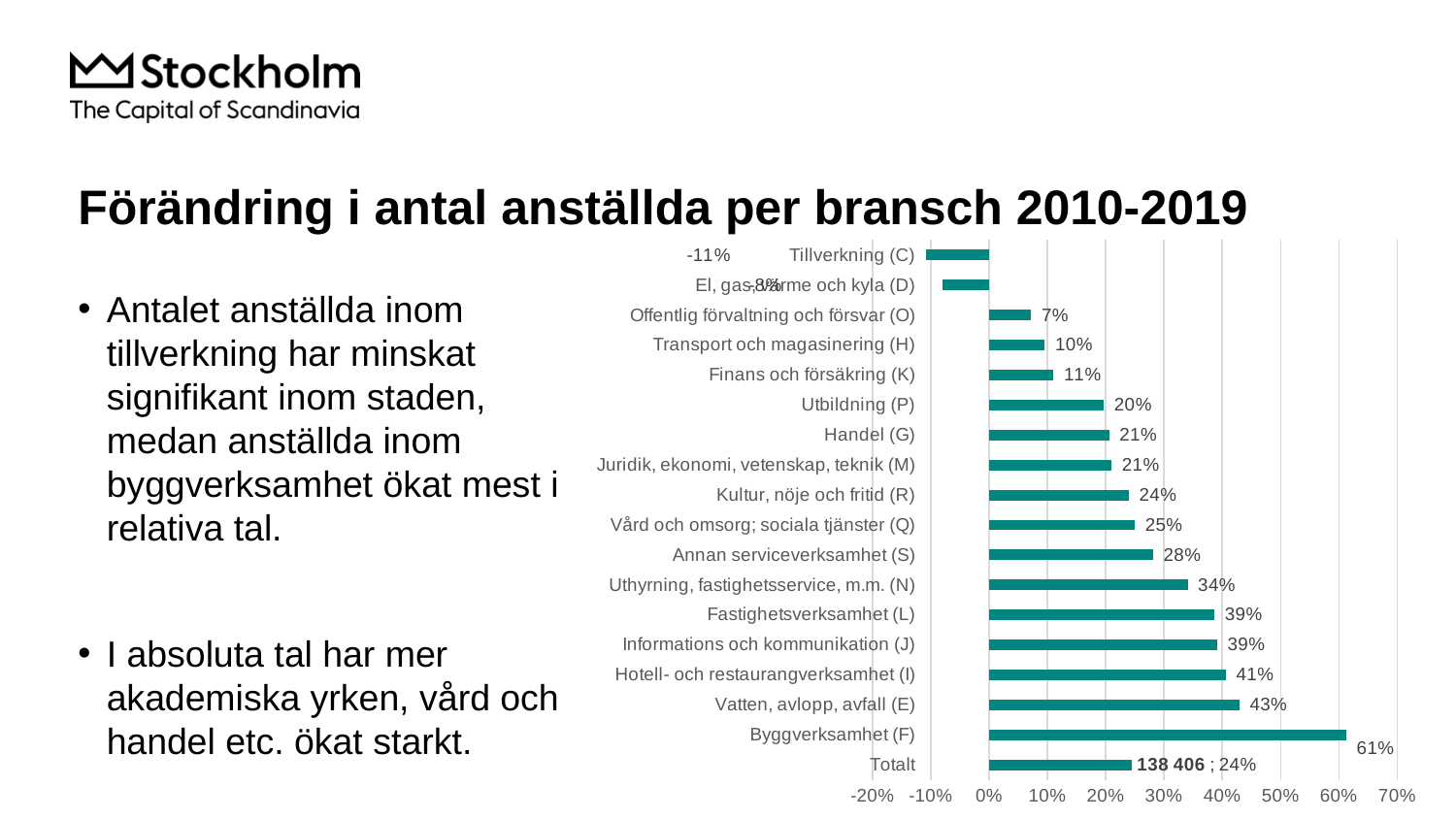
What is the value for Byggverksamhet (F)? 61% What is the value for Tillverkning (C)? -11% Which has a larger value, Utbildning (P) or Annan serviceverksamhet (S)? Annan serviceverksamhet (S) Which category has the lowest value? Tillverkning (C) How many categories (bars) are shown in the chart, including Totalt? 18 Which category has the highest value? Byggverksamhet (F) What is the value for Uthyrning, fastighetsservice, m.m. (N)? 34% What is the difference between the values for Vatten, avlopp, avfall (E) and Hotell- och restaurangverksamhet (I)? 2 percentage points What is the title of the chart on the slide? Förändring i antal anställda per bransch 2010-2019 What is the percentage value shown for Totalt? 24% What is the difference between the values for Byggverksamhet (F) and Tillverkning (C)? 72 percentage points What type of chart is shown on the slide? Bar chart